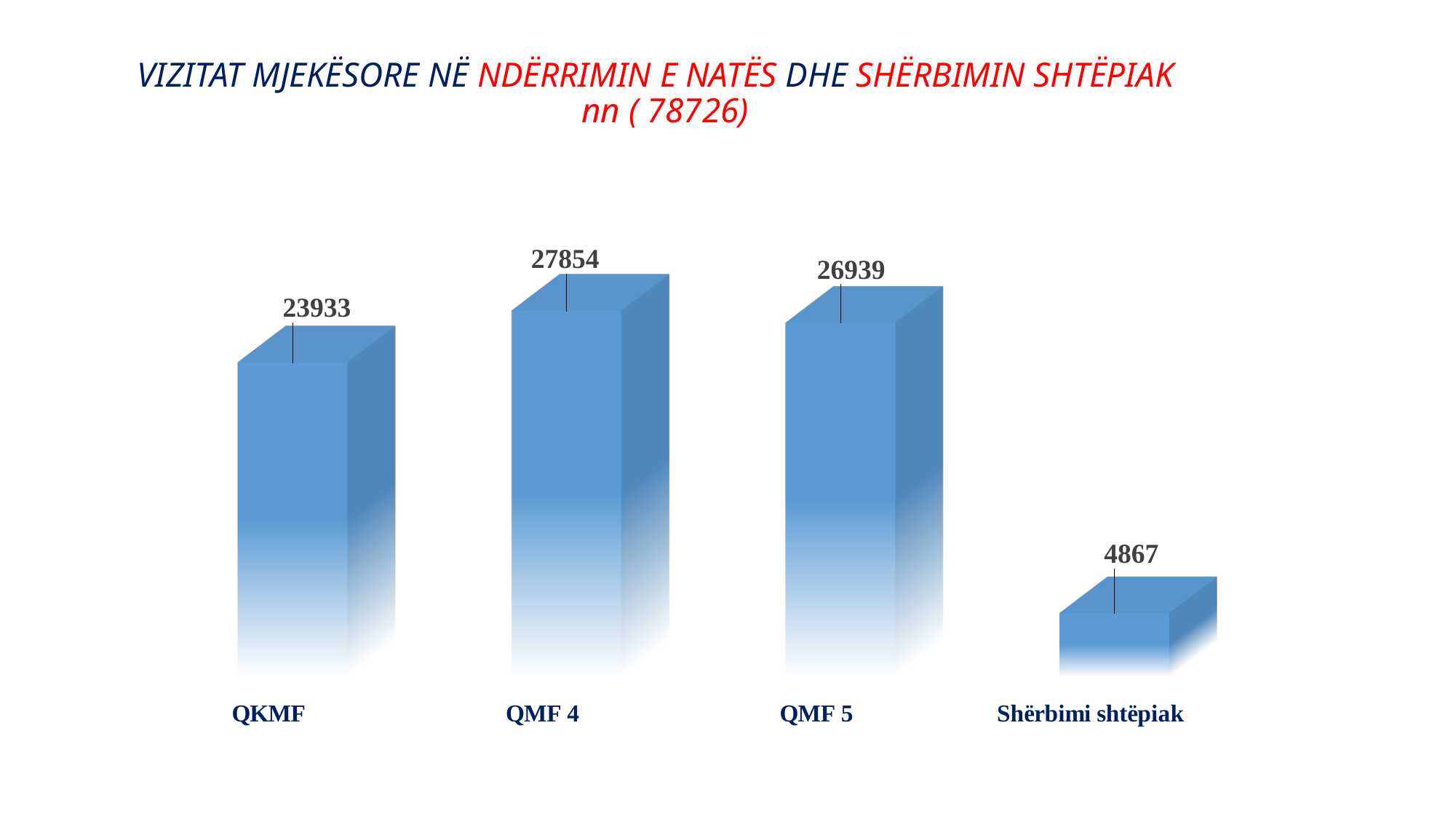
Which category has the highest value? QMF 4 Which category has the lowest value? Shërbimi shtëpiak How many categories are shown in the chart? 4 What is the difference between the values for QKMF and Shërbimi shtëpiak? 19066 What is the difference between the values for QMF 4 and QKMF? 3921 What is the value for QMF 5? 26939 What is the value for Shërbimi shtëpiak? 4867 What kind of chart is shown on the slide? Bar chart Which is larger, the value for QKMF or the value for QMF 5? QMF 5 What is the value for QMF 4? 27854 What is the value for QKMF? 23933 What is the difference between the values for QMF 4 and QMF 5? 915